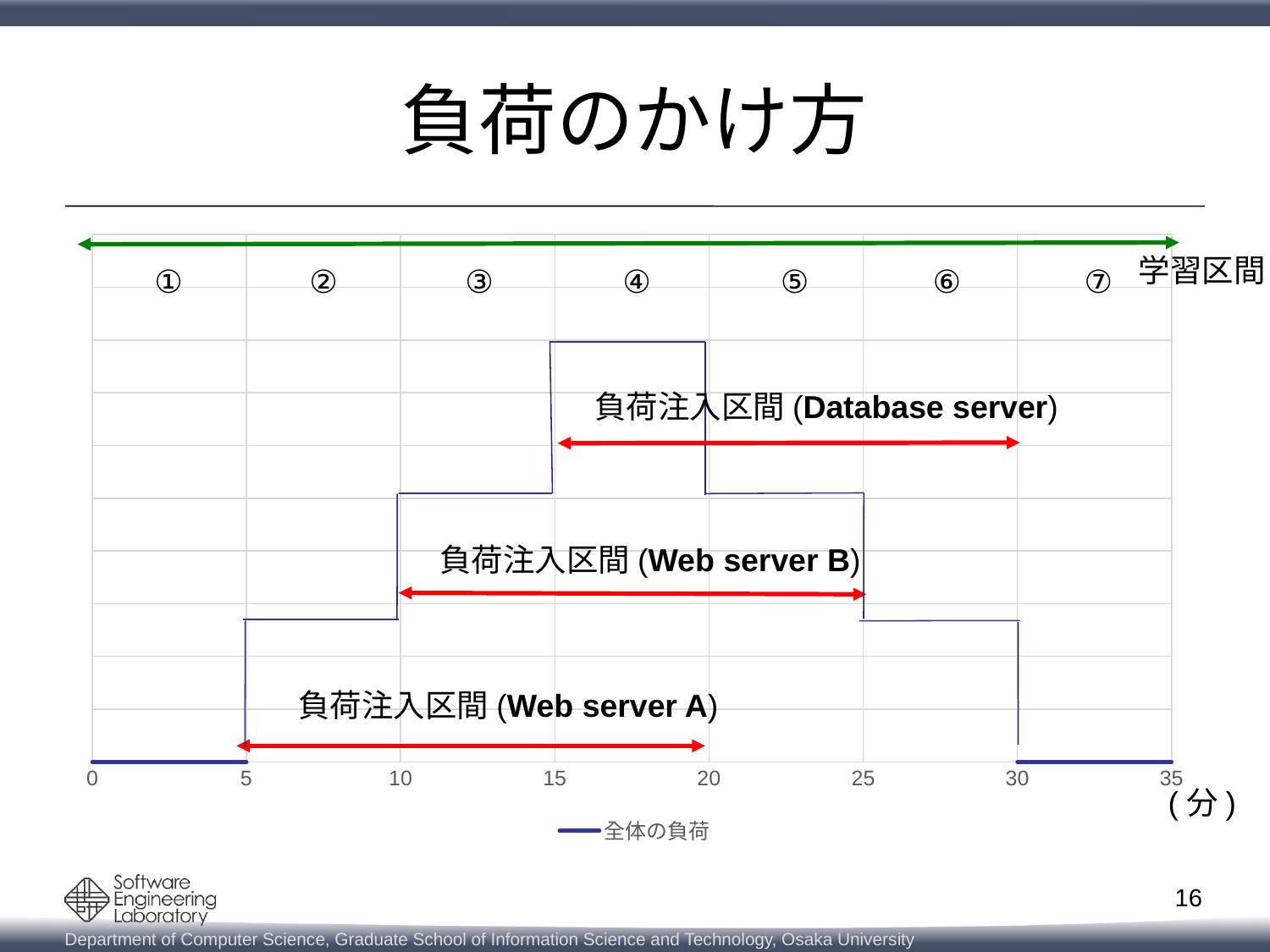
Which interval has the larger total load, ② or ③? ③ What unit is shown for the x axis of the chart? 分 How many numbered intervals (①–⑦) are marked along the top of the chart? 7 Between which x-axis values does the total load reach its highest level? 15 and 20 Over which range of minutes does the load injection interval for the Database server (負荷注入区間 Database server) extend? 15 to 30 Does the total load rise or fall along the x axis from 0 to 15 minutes? rise How many series does the chart legend list? 1 Over which range of minutes does the load injection interval for Web server A (負荷注入区間 Web server A) extend? 5 to 20 In which numbered interval is the total load (全体の負荷) highest? ④ What is the name of the series shown in the chart legend? 全体の負荷 Does the total load rise or fall along the x axis from 20 to 35 minutes? fall What kind of chart is shown on the slide? line chart